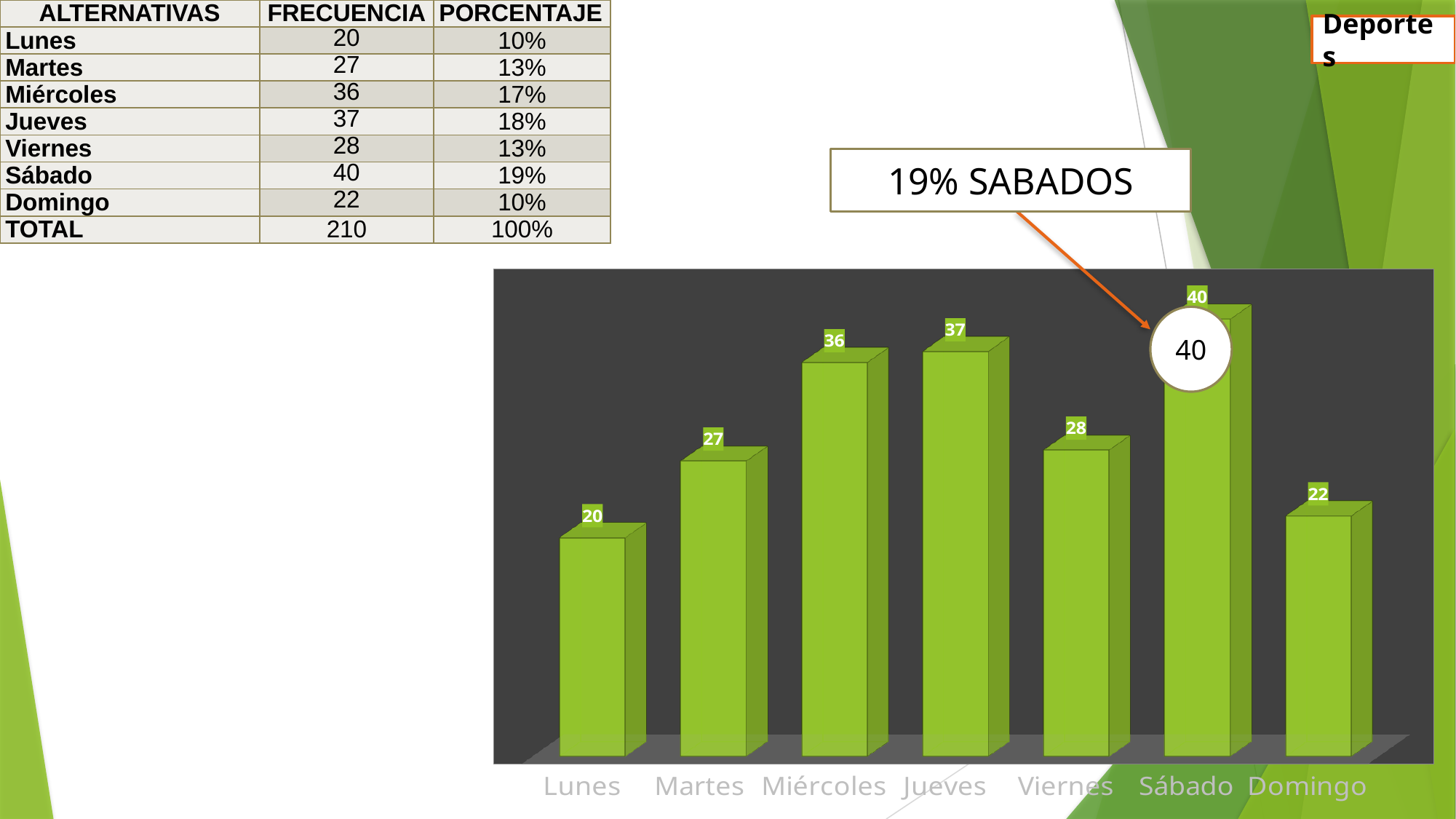
Do the values rise or fall from Lunes to Jueves? Rise What is the value for Lunes in the bar chart? 20 Which is larger, the value for Viernes or the value for Martes? Viernes Which category has the lowest value in the bar chart? Lunes What is the value for Miércoles in the bar chart? 36 What kind of chart is shown on the slide? Bar chart What is the difference between the values for Sábado and Domingo? 18 What is the value for Sábado in the bar chart? 40 Which category has the highest value in the bar chart? Sábado What is the difference between the values for Jueves and Martes? 10 What text does the callout box above the chart show? 19% SABADOS How many categories are shown in the bar chart? 7